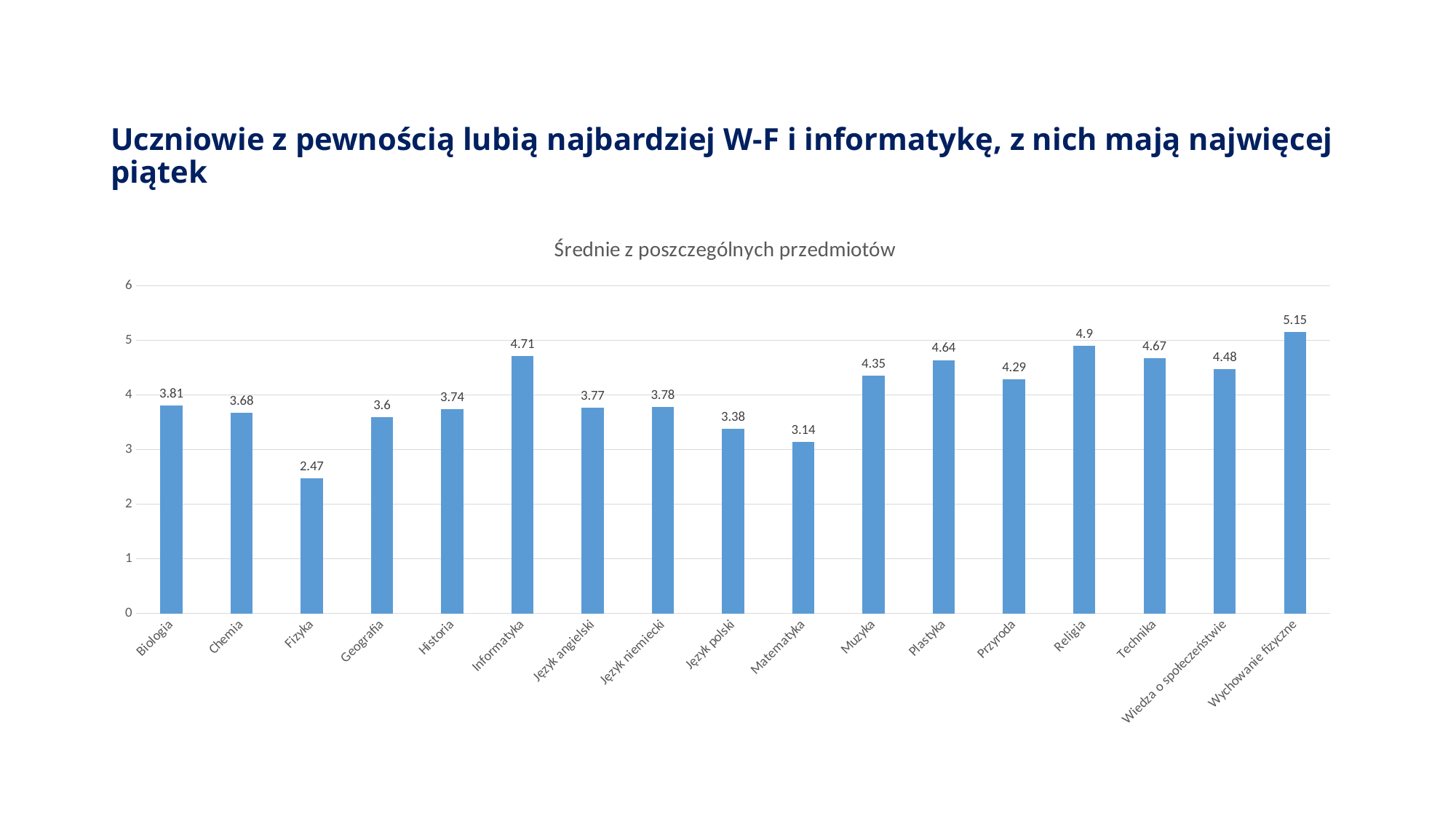
Which has a higher average, Plastyka or Muzyka? Plastyka What is the average for Fizyka? 2.47 What is the title of the chart? Średnie z poszczególnych przedmiotów What is the difference between the averages for Wychowanie fizyczne and Informatyka? 0.44 Which subject has the highest average? Wychowanie fizyczne How many subjects are shown on the chart? 17 What is the average for Informatyka? 4.71 What kind of chart is shown on the slide? bar chart Which subject has the lowest average? Fizyka Is the average for Język polski greater or less than 4? less What is the difference between the averages for Religia and Matematyka? 1.76 What is the average for Wiedza o społeczeństwie? 4.48